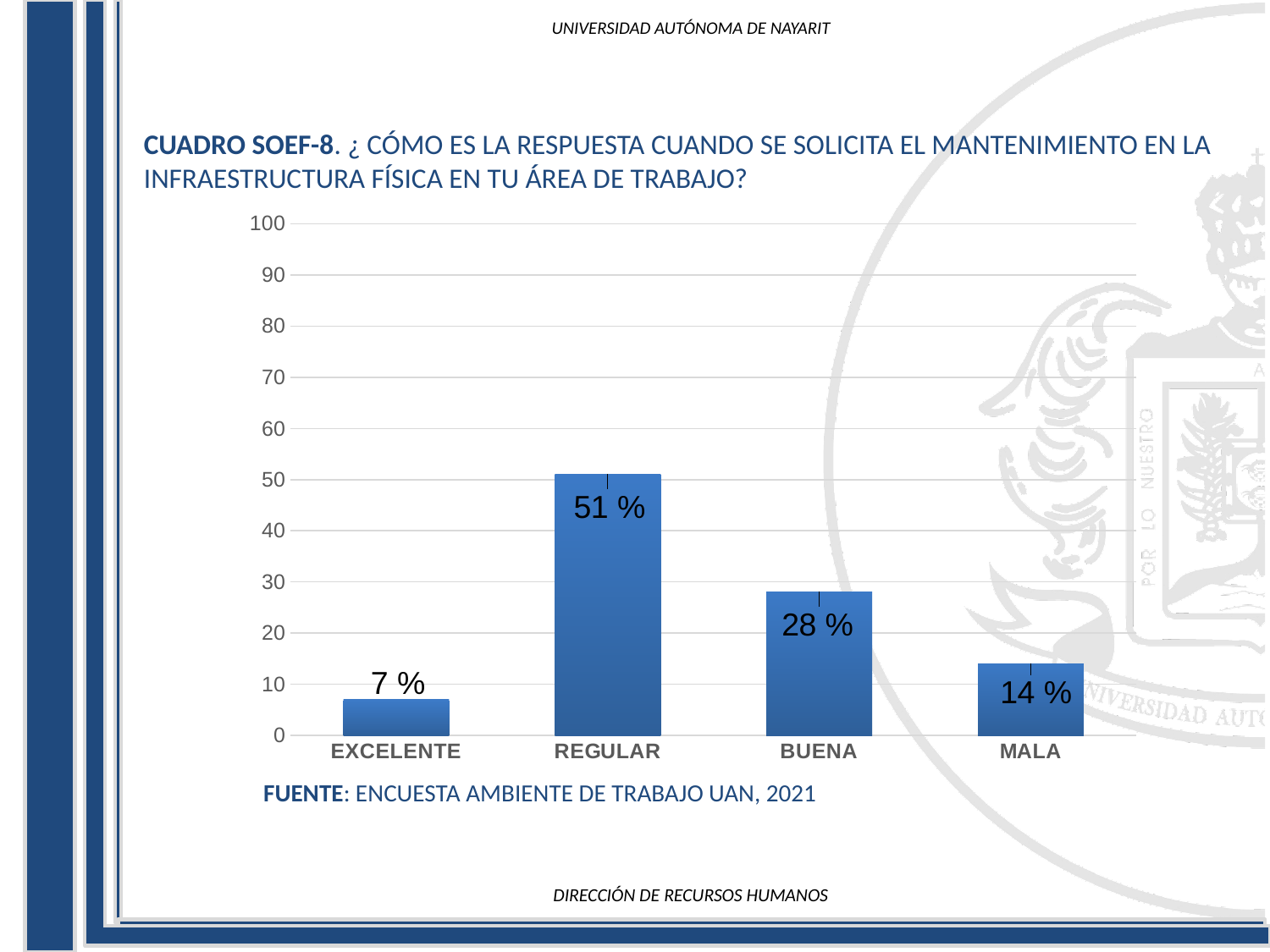
What is the source cited below the chart? ENCUESTA AMBIENTE DE TRABAJO UAN, 2021 What is the value for REGULAR? 51 % How many categories are shown on the x axis? 4 What kind of chart is shown on the slide? bar chart Which category has the highest value? REGULAR Is the value for REGULAR greater or less than 50? greater Which is larger, the value for BUENA or the value for MALA? BUENA What is the value for MALA? 14 % Which category has the lowest value? EXCELENTE What is the difference between the values for REGULAR and BUENA? 23 % What is the value for EXCELENTE? 7 % What is the value for BUENA? 28 %